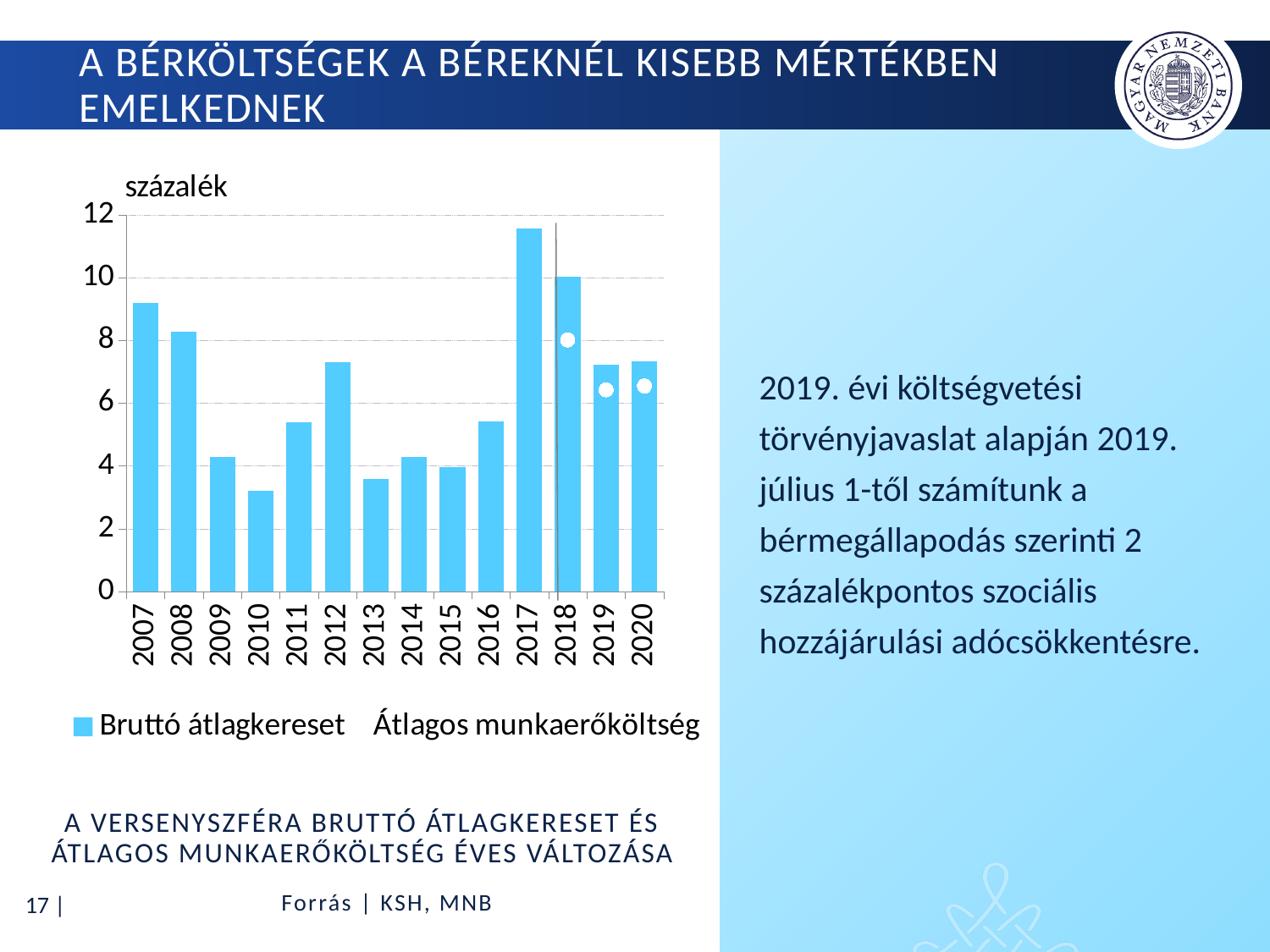
Which year has the larger Bruttó átlagkereset value, 2017 or 2018? 2017 What unit label is shown above the vertical axis of the chart? százalék Is the Átlagos munkaerőköltség value for 2019 greater or less than 8? less How many years are shown on the x axis of the chart? 14 Is the Bruttó átlagkereset value for 2017 greater or less than 10? greater Do the Bruttó átlagkereset values rise or fall from 2007 to 2010? fall Which year has the highest Bruttó átlagkereset bar? 2017 Is the Bruttó átlagkereset value for 2007 greater or less than 8? greater How many series does the chart legend list? 2 What kind of chart is shown on the slide? bar chart Which year has the lowest Bruttó átlagkereset bar? 2010